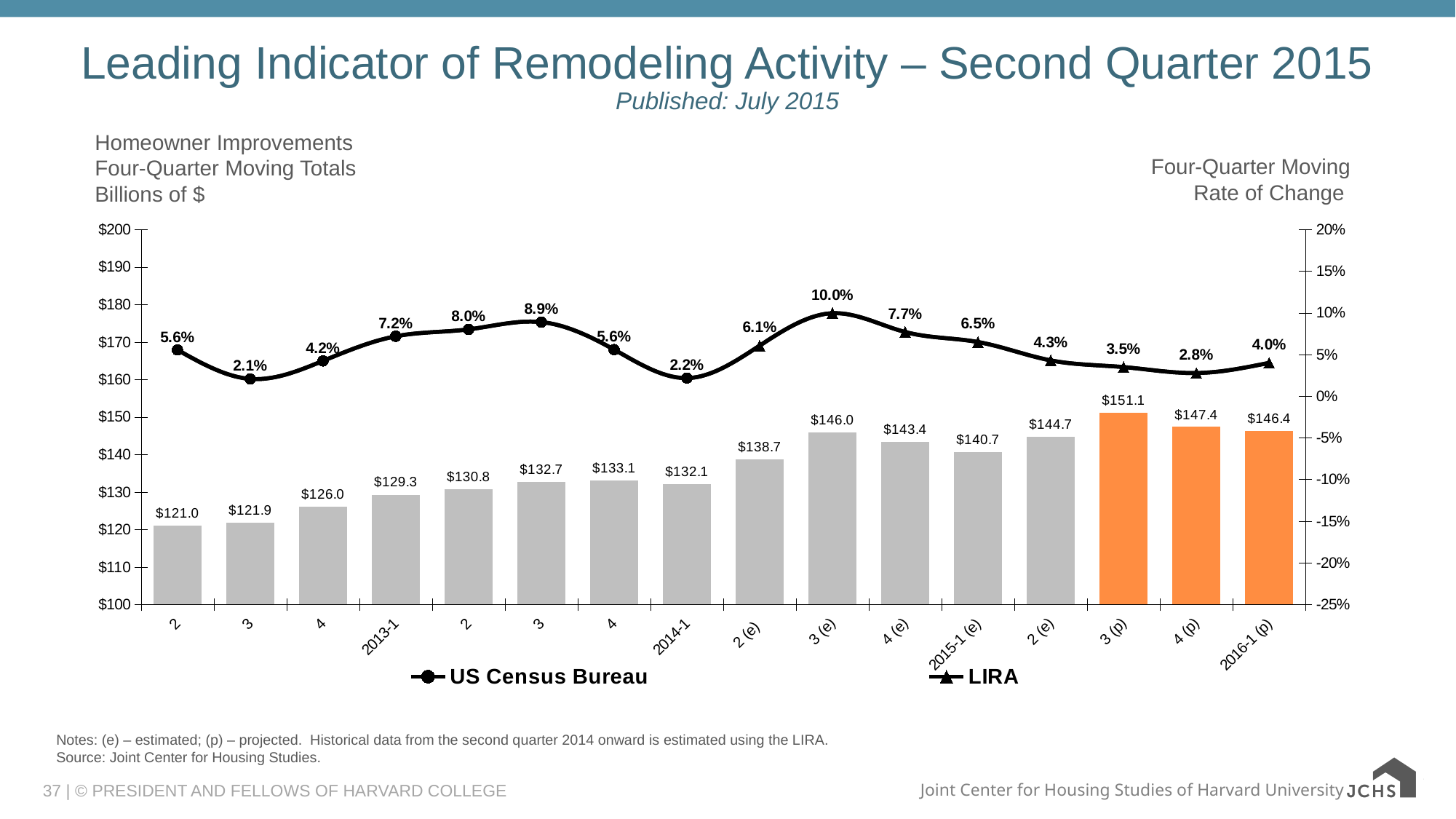
Which category has the highest four-quarter moving rate of change? 3 (e) What kind of chart is this? Combination bar and line chart What is the difference between the four-quarter moving totals for 3 (p) and 4 (p)? $3.7 Which has the larger four-quarter moving total, 2014-1 or 2015-1 (e)? 2015-1 (e) How many categories are shown on the x axis? 16 What is the four-quarter moving total for 2013-1? $129.3 What is the four-quarter moving total for 3 (p)? $151.1 How many series does the legend list? 2 Which category has the highest four-quarter moving total bar? 3 (p) What is the four-quarter moving rate of change for 3 (e)? 10.0% What is the lowest four-quarter moving total shown on the chart? $121.0 What is the lowest four-quarter moving rate of change shown on the chart? 2.1%